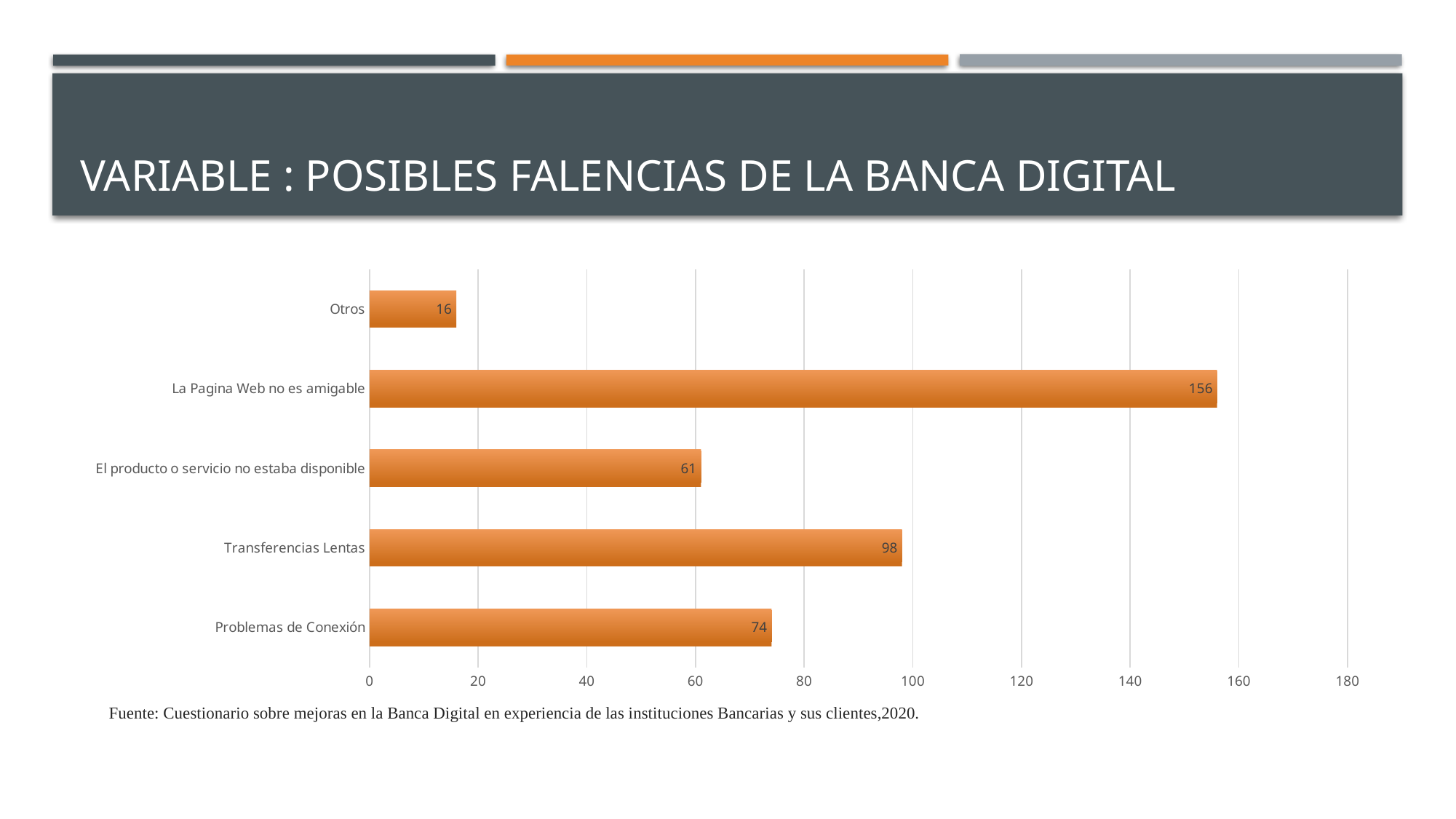
What is the value for El producto o servicio no estaba disponible? 61 What is the value for Transferencias Lentas? 98 What colour are the bars in the chart? orange Is the value for Transferencias Lentas greater or less than 100? less Which category has the highest value? La Pagina Web no es amigable Which is larger, the value for Problemas de Conexión or the value for El producto o servicio no estaba disponible? Problemas de Conexión Which category has the lowest value? Otros What kind of chart is shown on the slide? bar chart What is the value for La Pagina Web no es amigable? 156 What is the difference between the values for La Pagina Web no es amigable and Transferencias Lentas? 58 What is the value for Problemas de Conexión? 74 How many categories are shown in the chart? 5